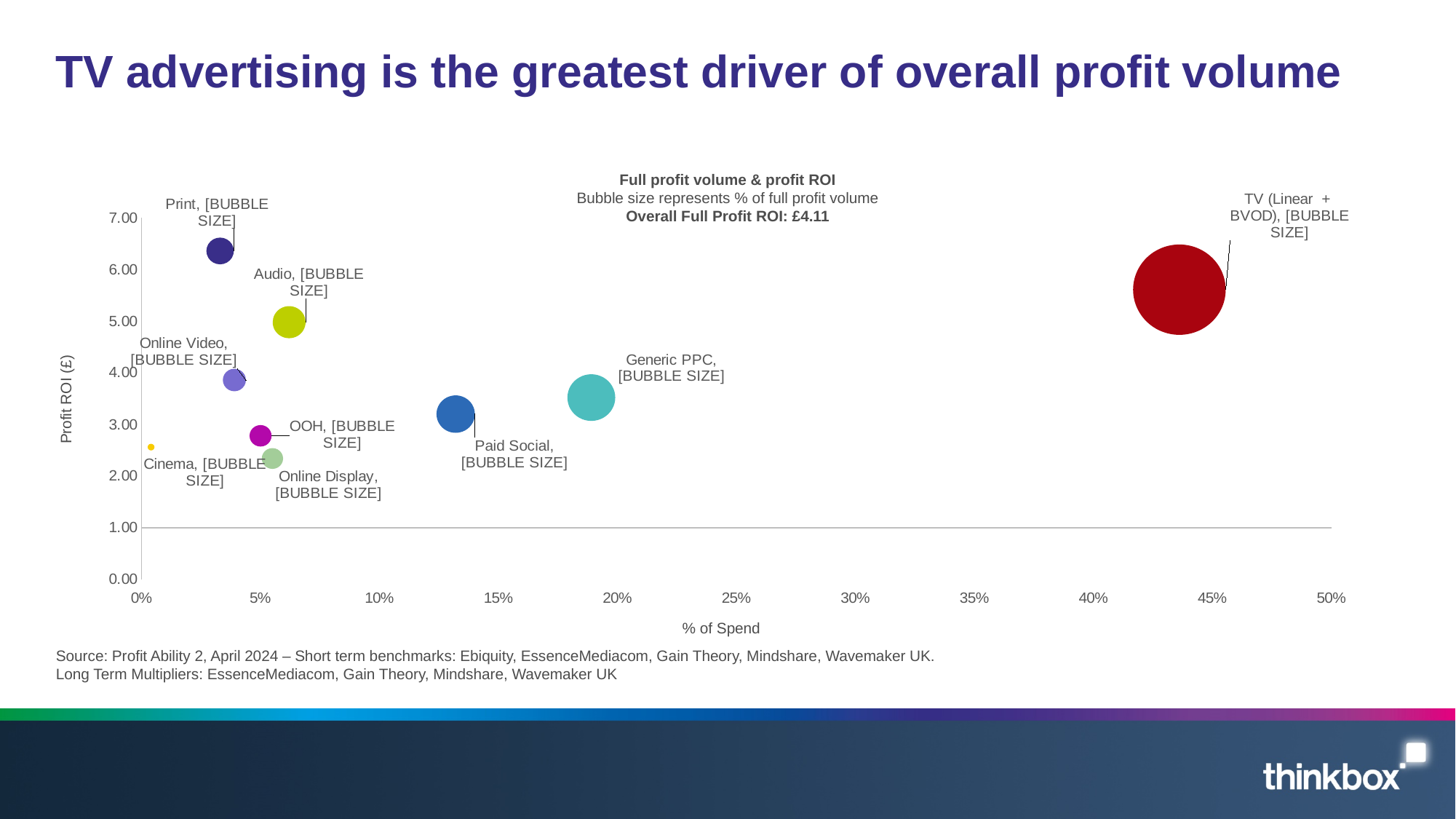
Which has the higher % of Spend, Generic PPC or Paid Social? Generic PPC How many media channels (bubbles) are plotted on the chart? 9 Which channel has the largest % of Spend? TV (Linear + BVOD) Is the % of Spend for TV (Linear + BVOD) greater or less than 40%? greater Is the Profit ROI for Paid Social greater or less than 4.00? less Which channel has the smallest % of Spend? Cinema What Overall Full Profit ROI is stated on the chart? £4.11 Is the Profit ROI for TV (Linear + BVOD) greater or less than 5.00? greater Which channel has the highest Profit ROI? Print Which has the higher Profit ROI, Print or Audio? Print Which channel has the largest bubble, i.e. the largest share of full profit volume? TV (Linear + BVOD) What kind of chart is shown on the slide? Bubble chart